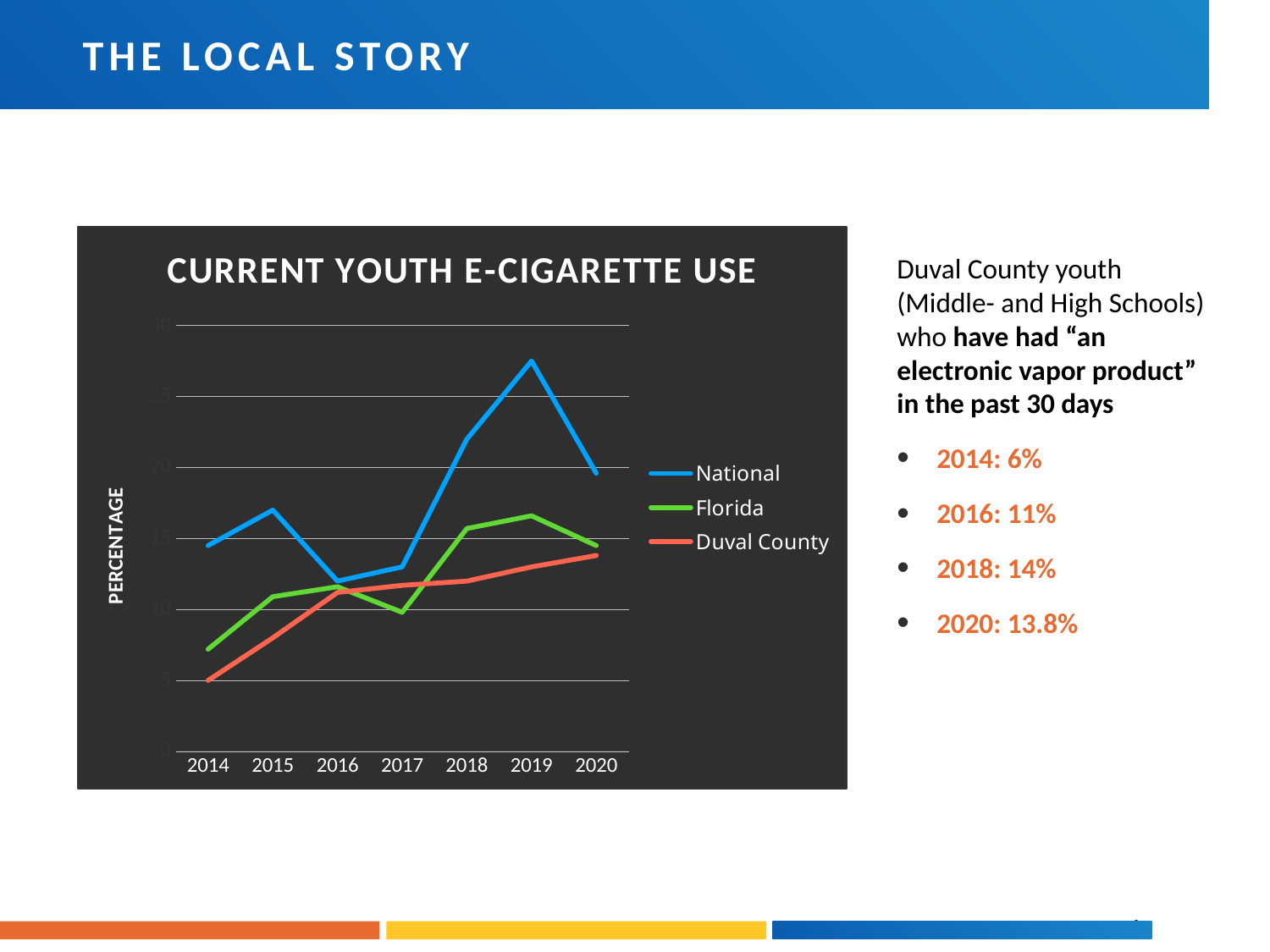
Is the National value for 2019 greater or less than 25? greater How many series does the chart's legend list? 3 What is the title of the chart? CURRENT YOUTH E-CIGARETTE USE Is the National value for 2018 greater or less than 20? greater Which series has the highest value in 2019? National Does the Duval County series generally rise or fall from 2014 to 2020? Rise What kind of chart is shown on the slide? Line chart In which year is the Florida series at its lowest value? 2014 In 2018, which is higher: the National value or the Florida value? National Is the Florida value for 2014 greater or less than 10? less How many years are shown on the x axis of the chart? 7 In which year does the National series reach its highest value? 2019